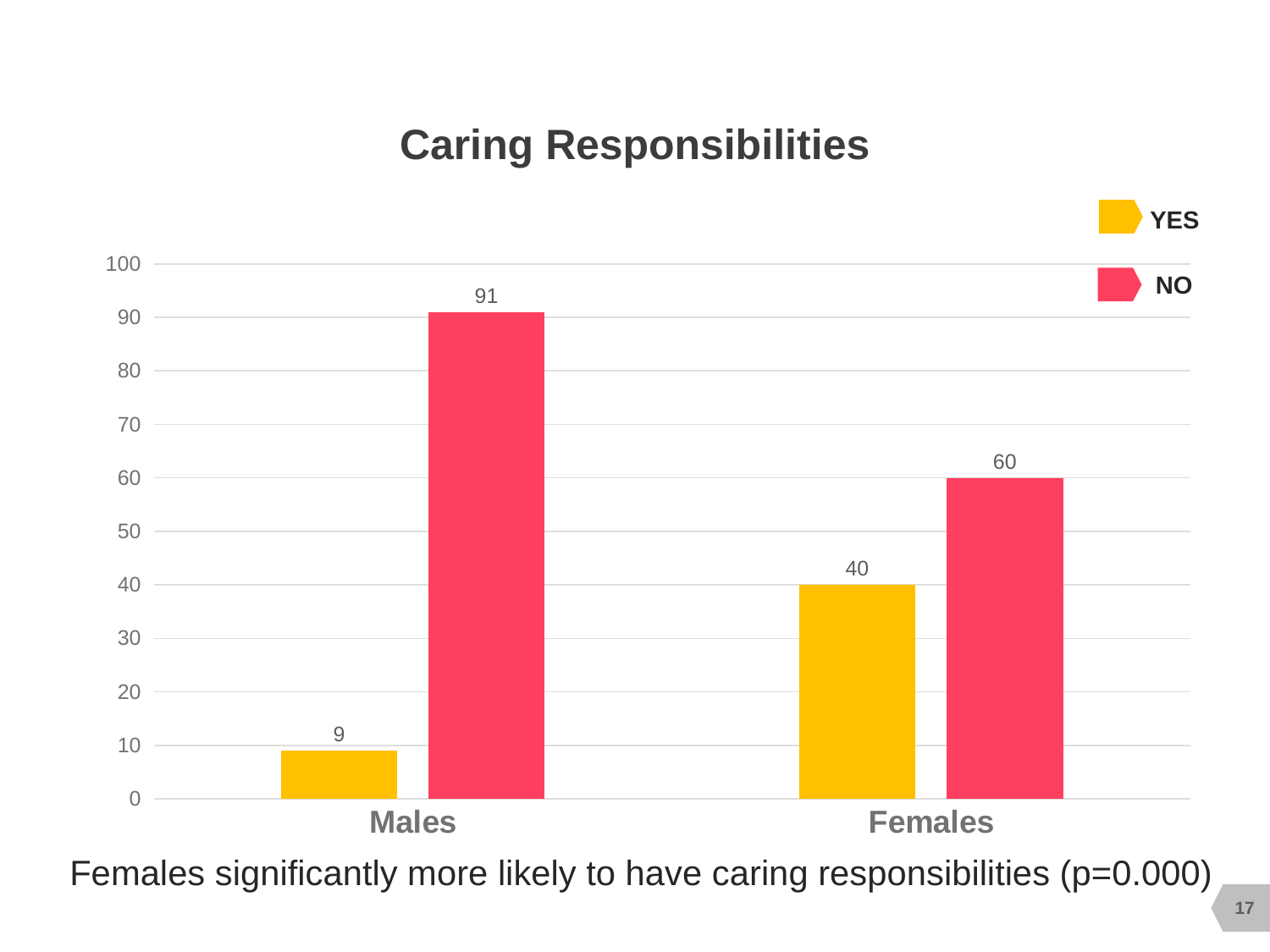
What is the title of the chart? Caring Responsibilities How many categories are shown on the x axis? 2 What kind of chart is shown on the slide? bar chart Which category has the highest NO value? Males What is the YES value for Females? 40 Is the NO value for Males greater or less than 80? greater Which is larger: the YES value for Females or the YES value for Males? Females What is the NO value for Females? 60 What is the difference between the NO values for Males and Females? 31 What is the YES value for Males? 9 How many series does the legend list? 2 Which category has the lowest YES value? Males